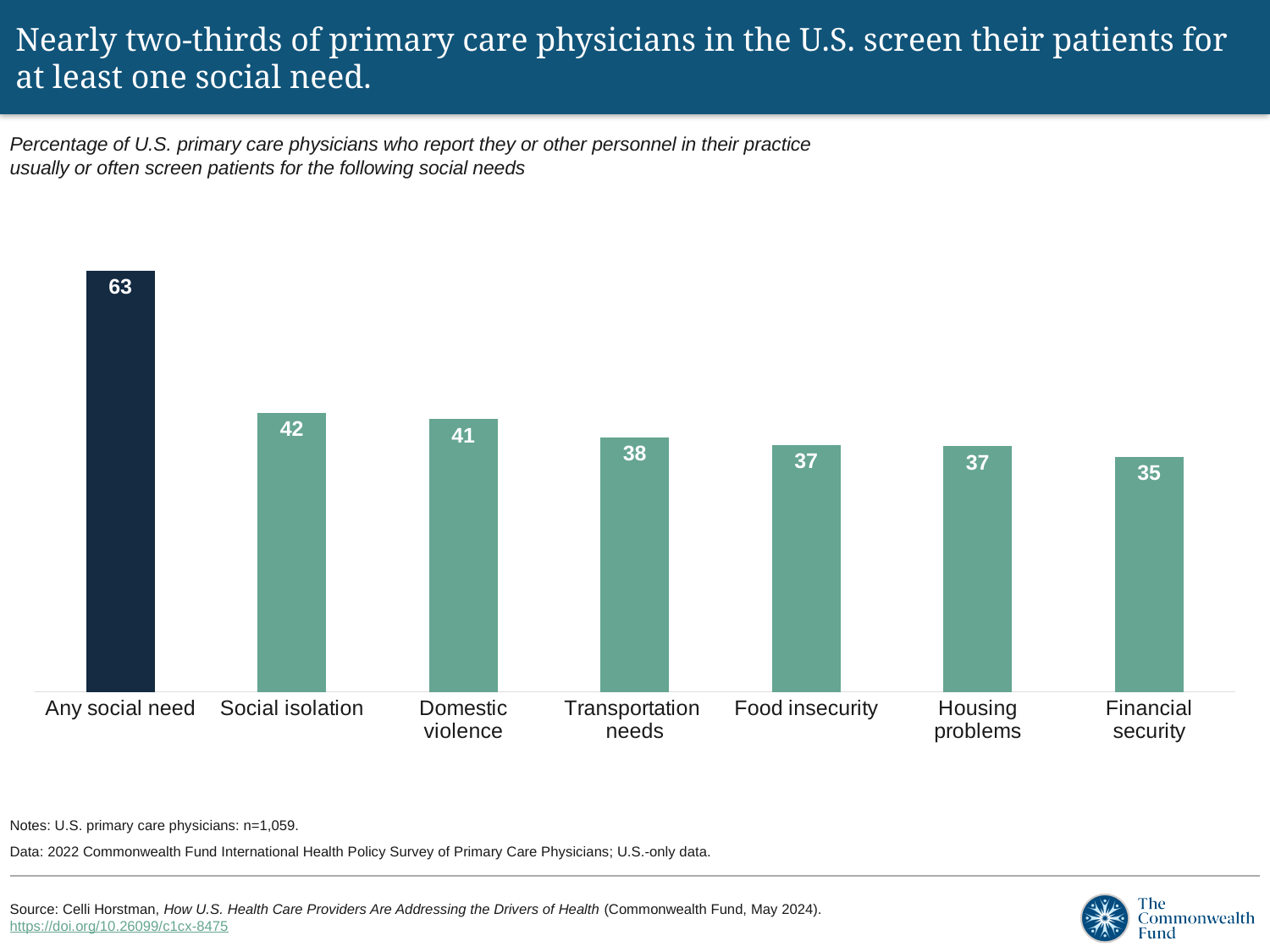
What is the difference between the values for Domestic violence and Financial security? 6 Which category has the lowest value? Financial security What kind of chart is shown on the slide? Bar chart What is the value for Any social need? 63 What is the value for Social isolation? 42 Which bar is shown in a different (dark navy) colour from the others? Any social need What is the value for Financial security? 35 Which category has the highest value? Any social need What is the difference between the values for Any social need and Social isolation? 21 What is the value for Transportation needs? 38 How many categories are shown in the chart? 7 Which is larger, the value for Social isolation or the value for Food insecurity? Social isolation